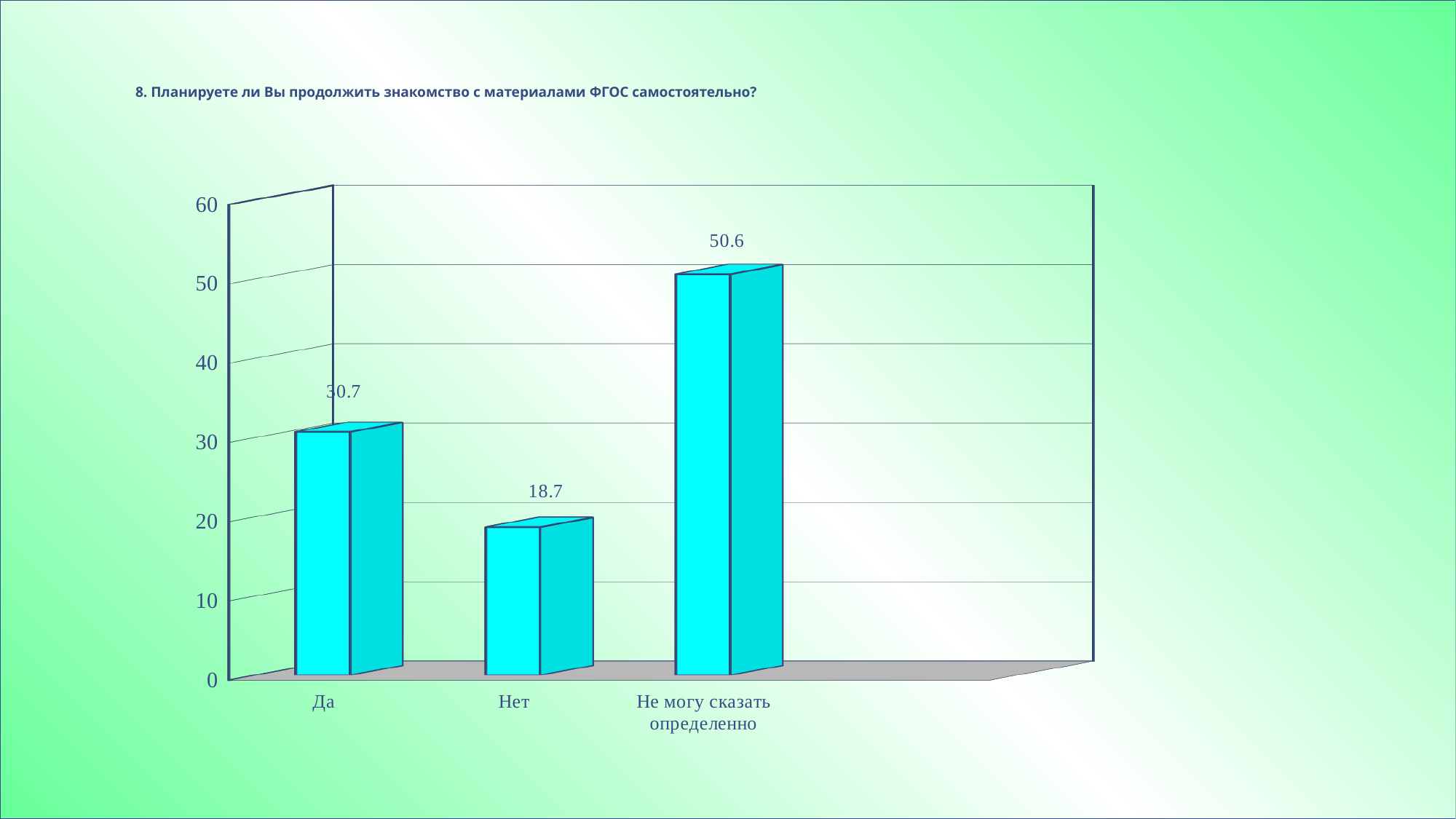
What is the value for "Нет"? 18.7 What is the title of the slide above the chart? 8. Планируете ли Вы продолжить знакомство с материалами ФГОС самостоятельно? What is the value for "Да"? 30.7 How many categories are shown on the x axis? 3 What is the value for "Не могу сказать определенно"? 50.6 Which category has the highest value? Не могу сказать определенно What is the difference between the values for "Не могу сказать определенно" and "Да"? 19.9 What is the difference between the values for "Да" and "Нет"? 12 Which is larger, the value for "Да" or the value for "Нет"? Да Is the value for "Не могу сказать определенно" greater or less than 50? greater Which category has the lowest value? Нет What kind of chart is shown on the slide? bar chart